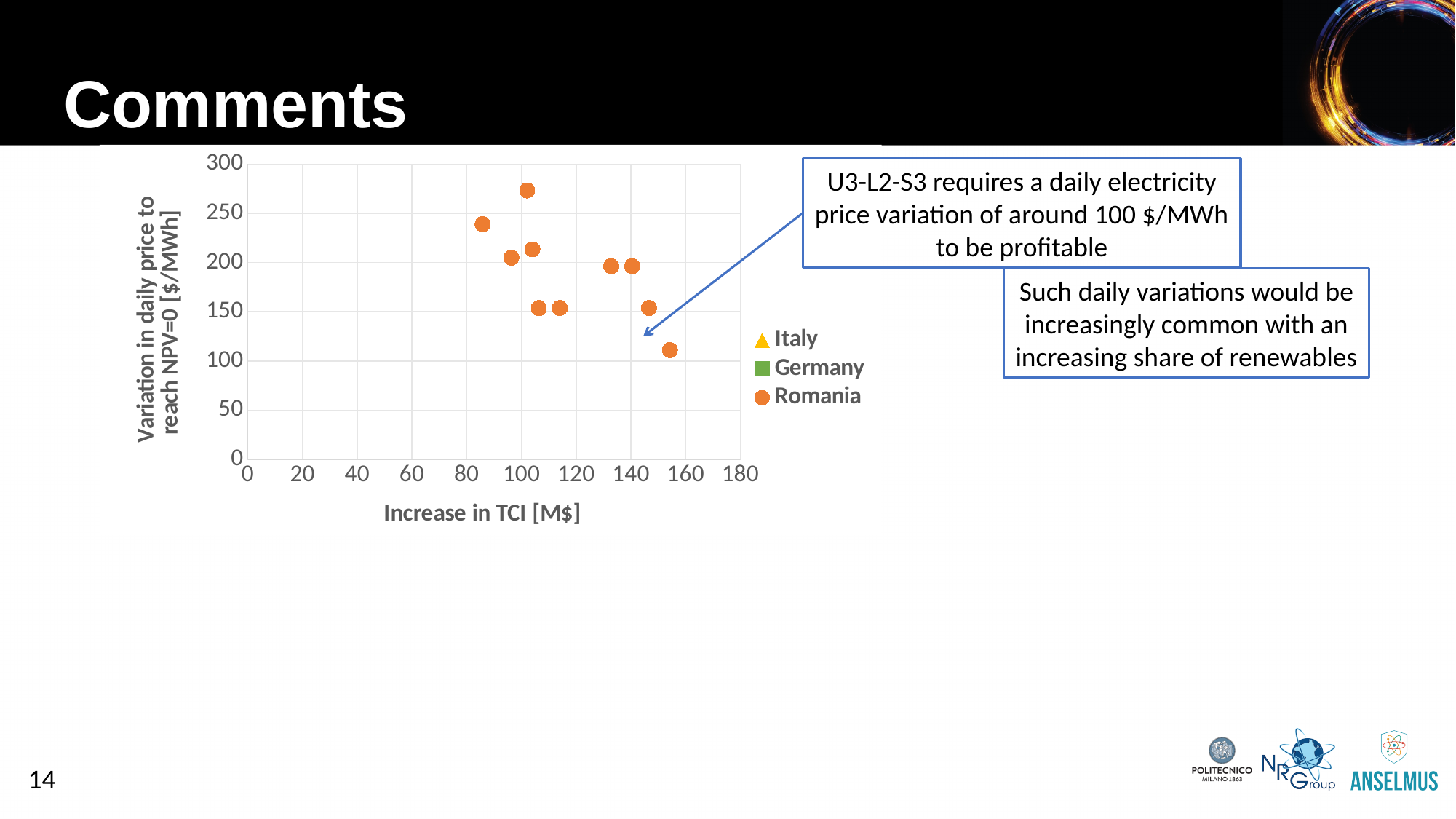
How many series does the chart legend list? 3 Is the smallest plotted increase in TCI greater or less than 100 M$? less What is the title of the x axis of the chart? Increase in TCI [M$] What kind of chart is shown on the slide? scatter chart Is the largest plotted increase in TCI greater or less than 140 M$? greater Which series do the plotted orange points belong to? Romania Is the lowest plotted variation in daily price greater or less than 100 $/MWh? greater How many data points are plotted on the chart? 10 Do the plotted variations in daily price generally rise or fall as the increase in TCI grows? fall Which series are listed in the chart legend? Italy, Germany, Romania